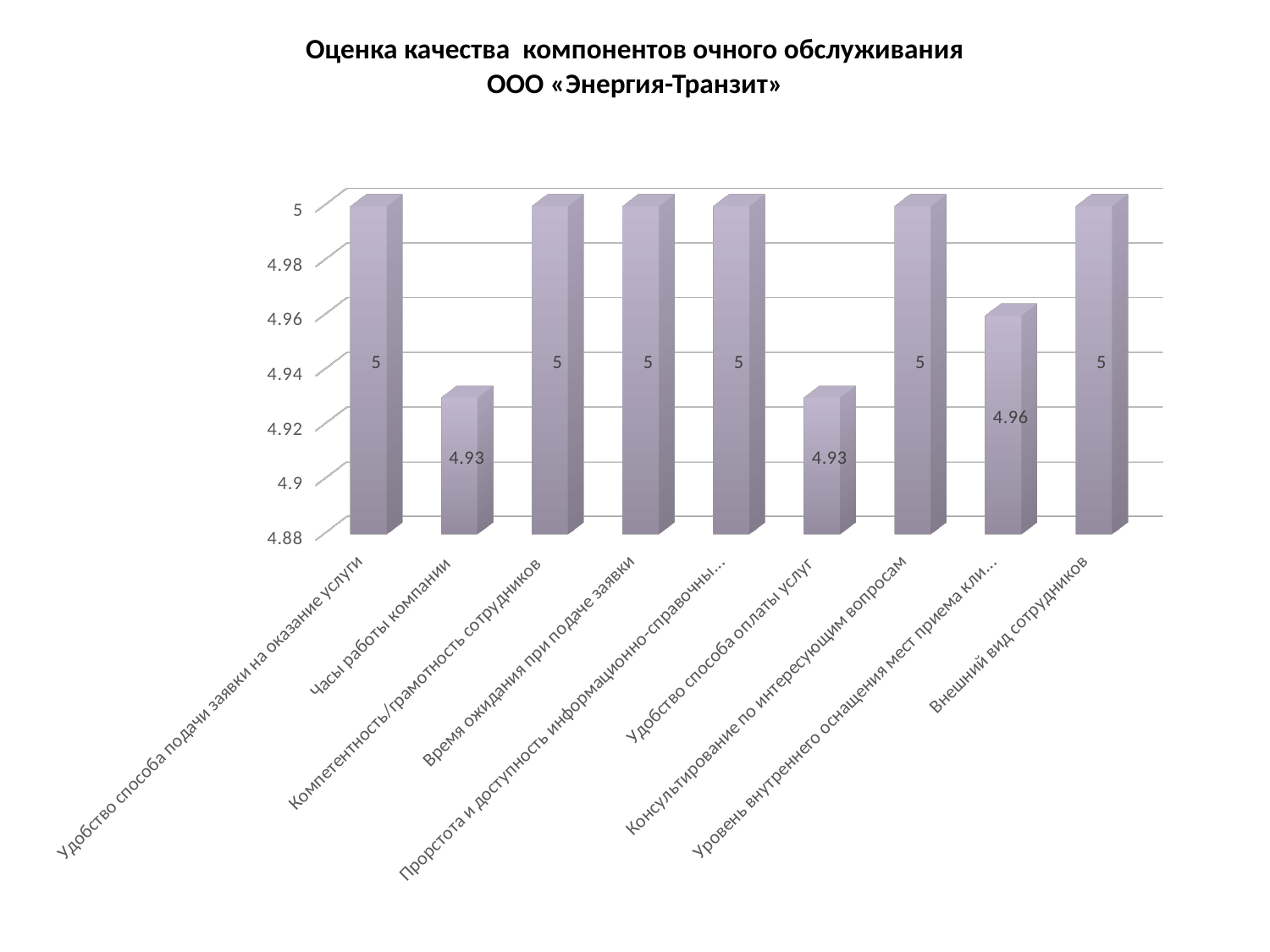
What is the difference between the value for "Время ожидания при подаче заявки" and the value for "Часы работы компании"? 0.07 What is the value for "Часы работы компании"? 4.93 What is the value for "Удобство способа оплаты услуг"? 4.93 What is the difference between the value for "Уровень внутреннего оснащения мест приема кли…" and the value for "Удобство способа оплаты услуг"? 0.03 How many categories are shown on the x axis? 9 What is the title of the chart? Оценка качества компонентов очного обслуживания ООО «Энергия-Транзит» What is the value for "Внешний вид сотрудников"? 5 What kind of chart is shown on the slide? bar chart What is the value for "Уровень внутреннего оснащения мест приема кли…"? 4.96 Is the value for "Часы работы компании" greater or less than 4.94? less Which is larger: the value for "Консультирование по интересующим вопросам" or the value for "Уровень внутреннего оснащения мест приема кли…"? Консультирование по интересующим вопросам What is the value for "Компетентность/грамотность сотрудников"? 5